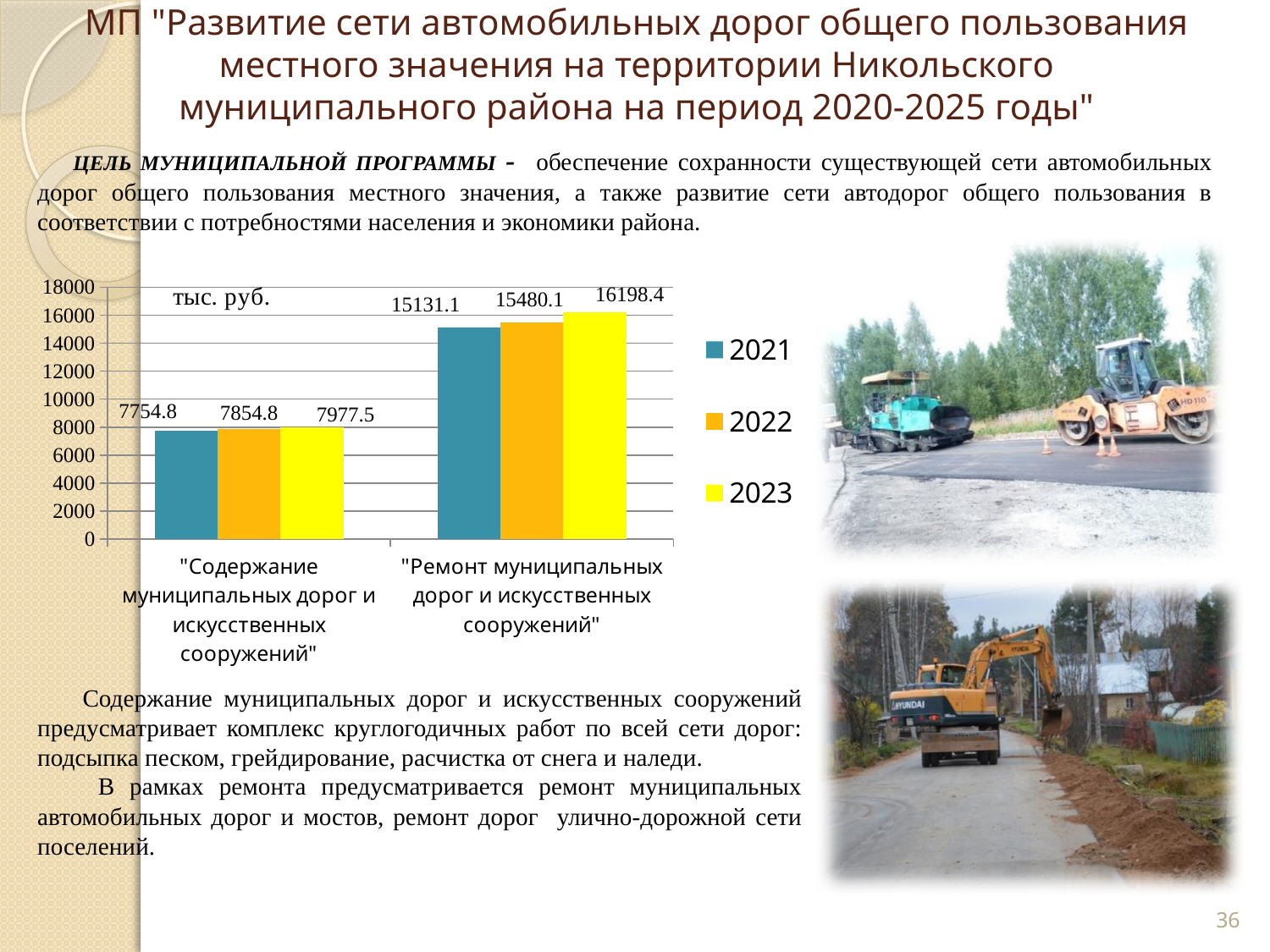
What type of chart is shown on the slide? bar chart What is the difference between the 2023 and 2021 values in the category "Ремонт муниципальных дорог и искусственных сооружений"? 1067.3 Which year has the lowest value in the category "Содержание муниципальных дорог и искусственных сооружений"? 2021 Do the values for "Содержание муниципальных дорог и искусственных сооружений" rise or fall from 2021 to 2023? rise What is the value for 2023 in the category "Ремонт муниципальных дорог и искусственных сооружений"? 16198.4 How many series does the chart legend list? 3 How many categories are shown on the x axis of the chart? 2 Which is larger: the 2022 value for "Содержание муниципальных дорог и искусственных сооружений" or the 2022 value for "Ремонт муниципальных дорог и искусственных сооружений"? "Ремонт муниципальных дорог и искусственных сооружений" What is the value for 2022 in the category "Ремонт муниципальных дорог и искусственных сооружений"? 15480.1 What unit is indicated on the chart? тыс. руб. Which year has the highest value in the category "Ремонт муниципальных дорог и искусственных сооружений"? 2023 What is the value for 2021 in the category "Содержание муниципальных дорог и искусственных сооружений"? 7754.8